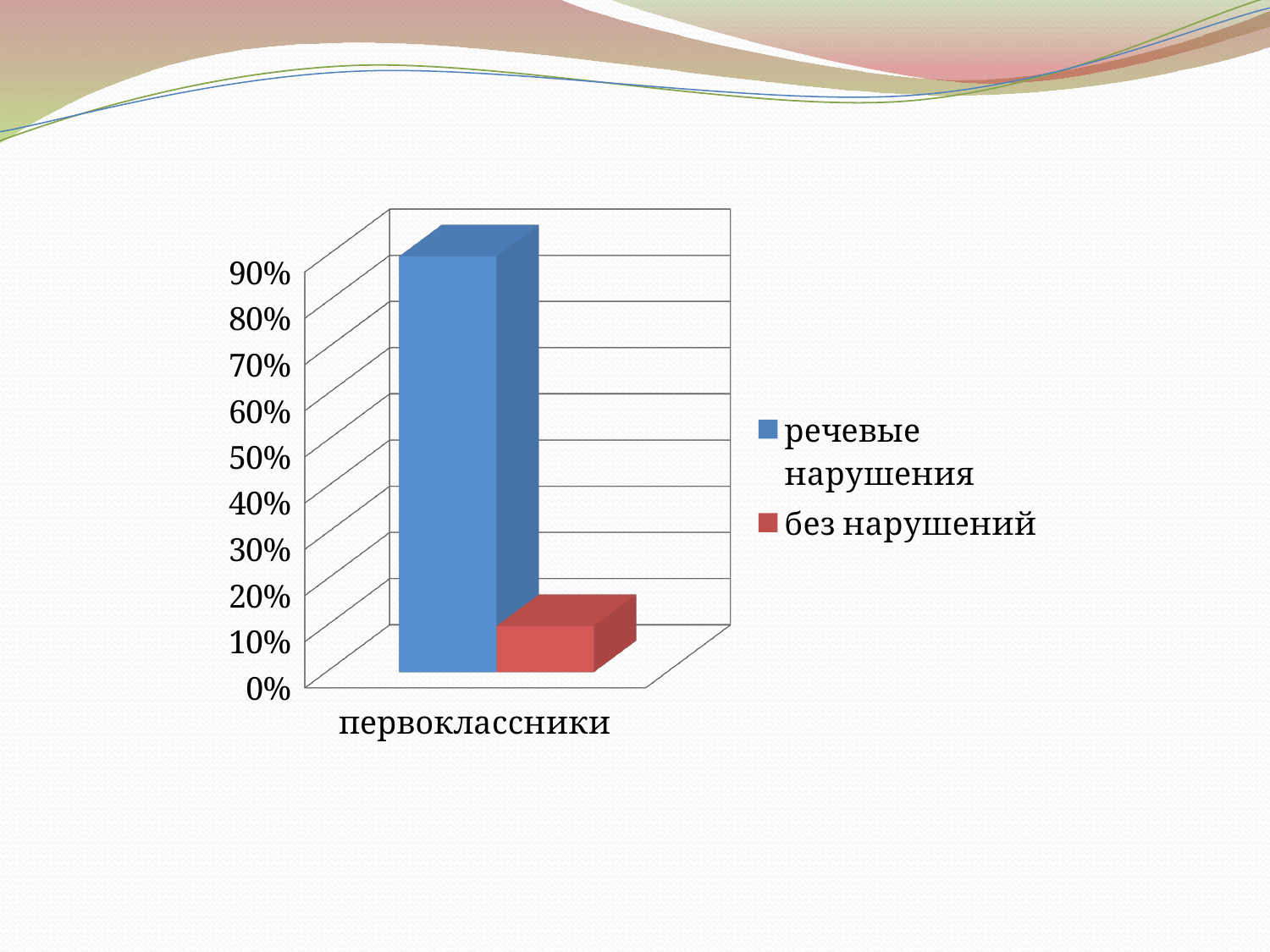
Is the value for без нарушений greater or less than 20%? less Which series has the higher value for первоклассники? речевые нарушения Which series has the lower value for первоклассники? без нарушений Is the value for речевые нарушения greater or less than 80%? greater How many series does the legend list? 2 What colour is the bar for без нарушений? red How many categories are shown on the x axis? 1 What is the label of the category on the x axis? первоклассники Is the value for речевые нарушения greater or less than 50%? greater Which is larger: the value for речевые нарушения or the value for без нарушений? речевые нарушения What kind of chart is shown on the slide? bar chart